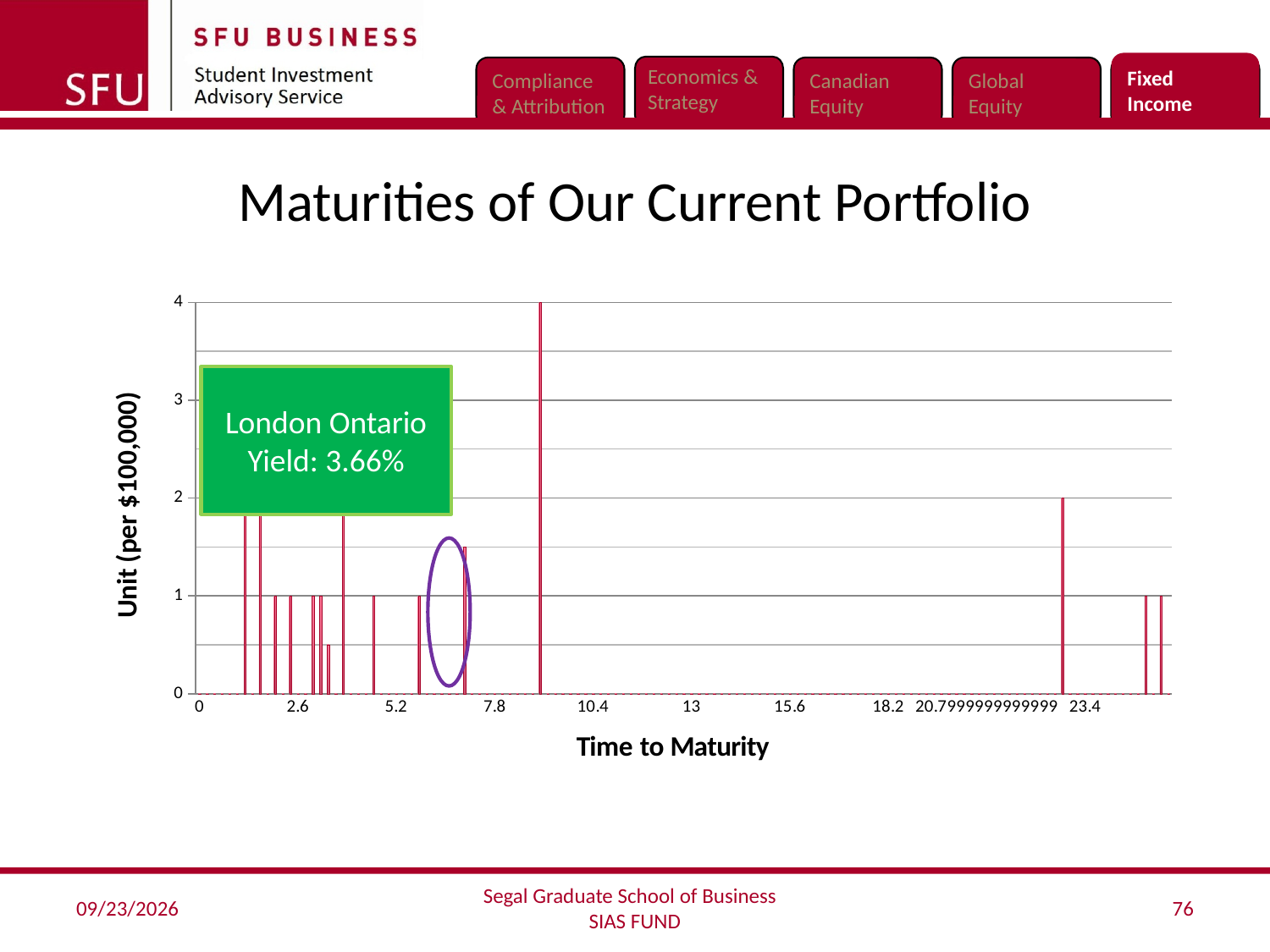
Is the bar circled in purple (between 5.2 and 7.8 on the x axis) greater or less than 2? less Is the tallest bar on the chart greater or less than 3? greater Is the bar circled in purple (between 5.2 and 7.8 on the x axis) greater or less than 1? greater What is the title of the chart? Maturities of Our Current Portfolio What is the maximum value shown on the y axis? 4 What is the highest value reached by any bar on the chart? 4 What is the label of the x axis? Time to Maturity Which is taller: the bar between 7.8 and 10.4 on the x axis or the bar just before 23.4? The bar between 7.8 and 10.4 What kind of chart is shown on the slide? Bar chart